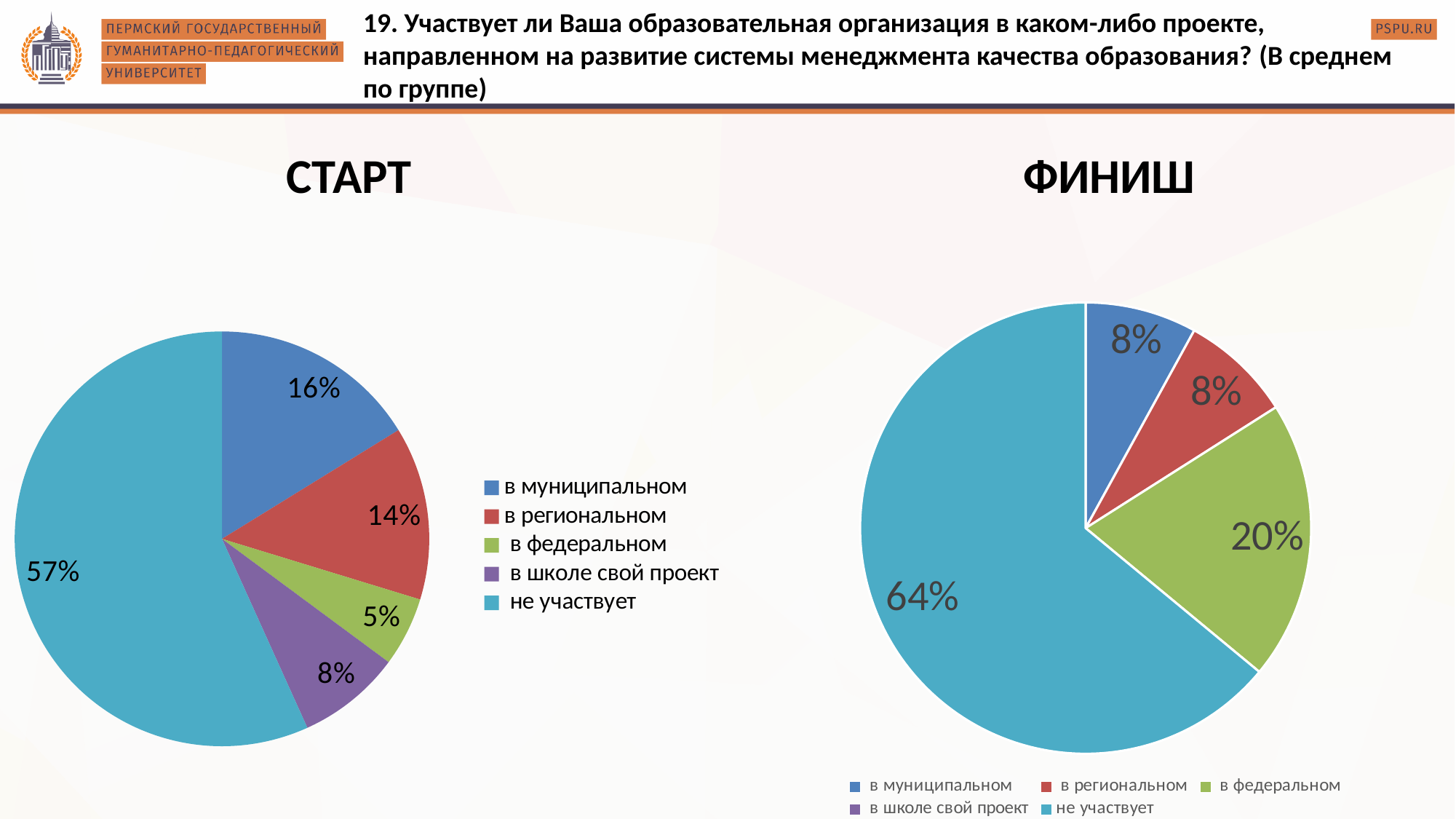
In the СТАРТ chart, what percentage is shown for 'в региональном'? 14% In the ФИНИШ chart, what percentage is shown for 'в федеральном'? 20% In the СТАРТ chart, what is the difference between 'в муниципальном' and 'в региональном'? 2% In the ФИНИШ chart, what share is labelled for the 'не участвует' slice? 64% In the СТАРТ chart, which category has the smallest slice? в федеральном In the СТАРТ chart, what share is labelled for the 'не участвует' slice? 57% How many entries does the legend of the СТАРТ chart list? 5 What type of chart is the СТАРТ chart? pie chart In the СТАРТ chart, what percentage is shown for 'в федеральном'? 5% Which is larger: 'в федеральном' in the СТАРТ chart or 'в федеральном' in the ФИНИШ chart? ФИНИШ In the ФИНИШ chart, which category has the largest slice? не участвует In the СТАРТ chart, which category has the largest slice? не участвует